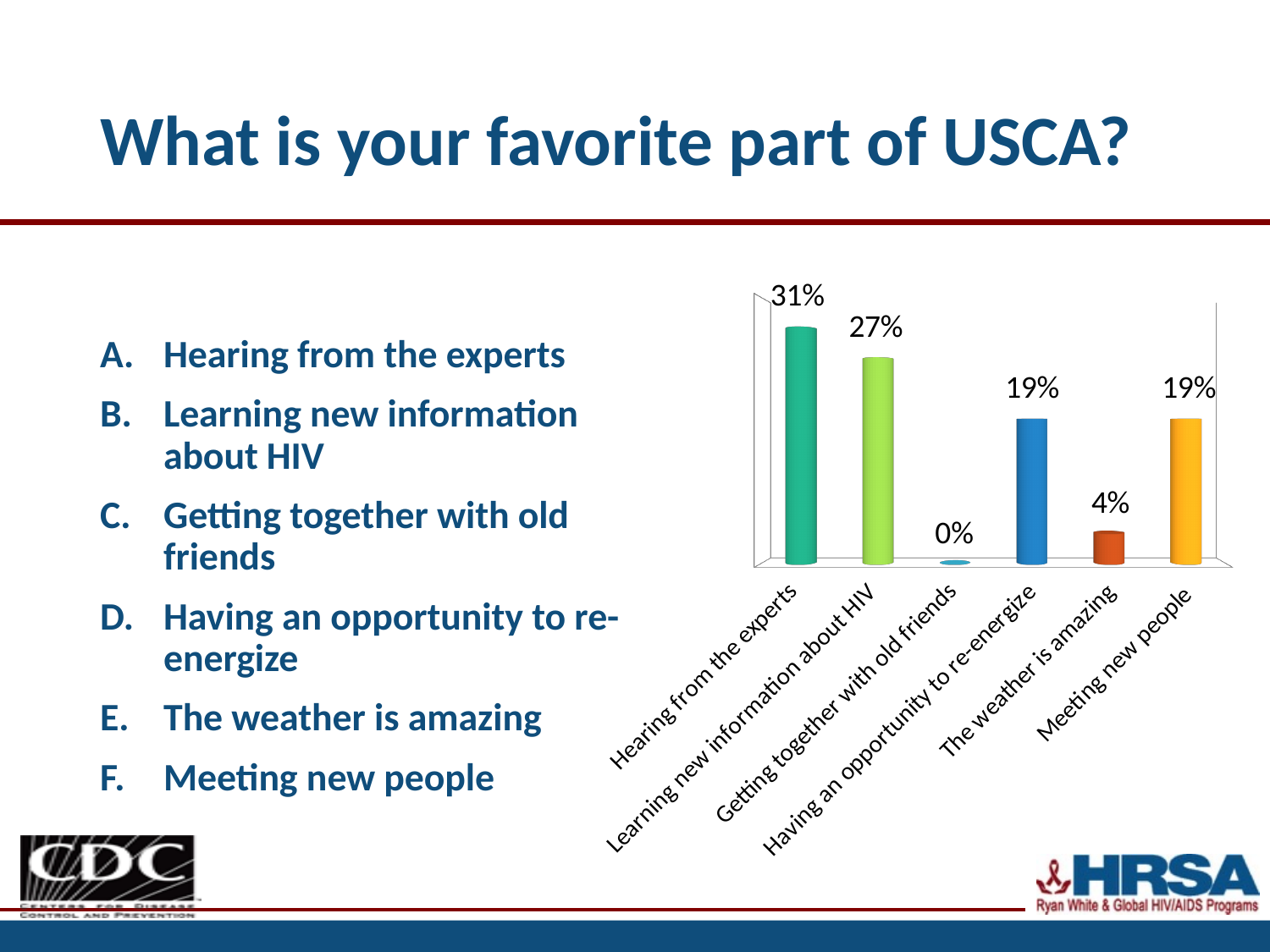
What is the value for "Getting together with old friends"? 0% Which category has the highest value? Hearing from the experts What kind of chart is shown on the slide? Bar chart What is the difference between the values for "Meeting new people" and "The weather is amazing"? 15% What is the value for "Meeting new people"? 19% What is the value for "Learning new information about HIV"? 27% How many categories are shown in the chart? 6 Which is larger, the value for "Having an opportunity to re-energize" or the value for "The weather is amazing"? Having an opportunity to re-energize What is the value for "Hearing from the experts"? 31% What is the difference between the values for "Hearing from the experts" and "Learning new information about HIV"? 4% Which category has the lowest value? Getting together with old friends What is the value for "The weather is amazing"? 4%